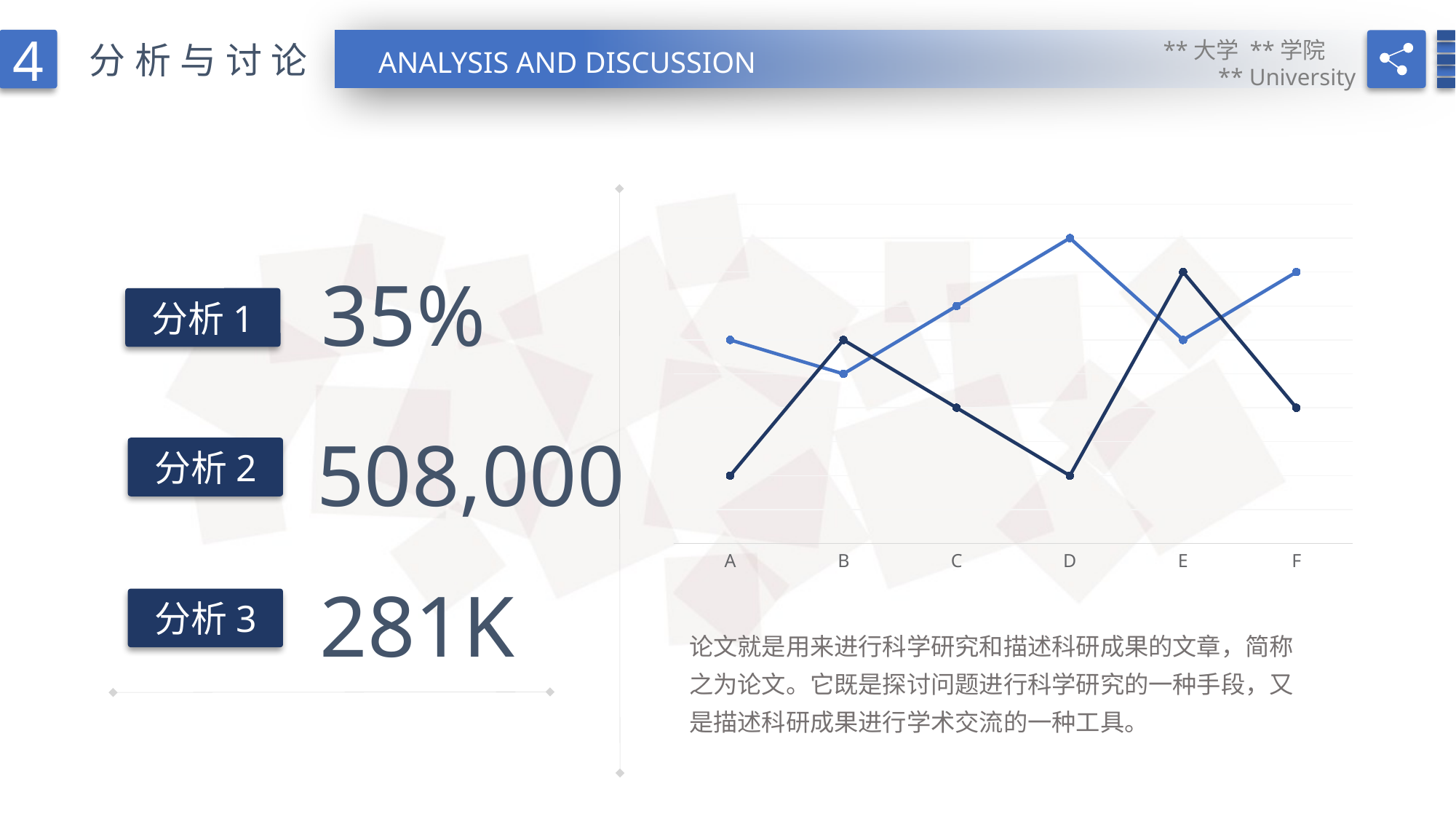
At category E, which line is higher, the light blue line or the dark navy line? dark navy line At category B, which line is higher, the light blue line or the dark navy line? dark navy line How many categories are shown on the x axis of the line chart? 6 At which category does the light blue line reach its lowest point? B At category A, which line is higher, the light blue line or the dark navy line? light blue line How many lines are plotted on the line chart? 2 At which category does the dark navy line reach its highest point? E Does the dark navy line rise or fall from B to D? fall What are the category labels on the x axis of the line chart? A, B, C, D, E, F At which category does the light blue line reach its highest point? D What kind of chart is shown on the slide? line chart Does the light blue line rise or fall from B to D? rise